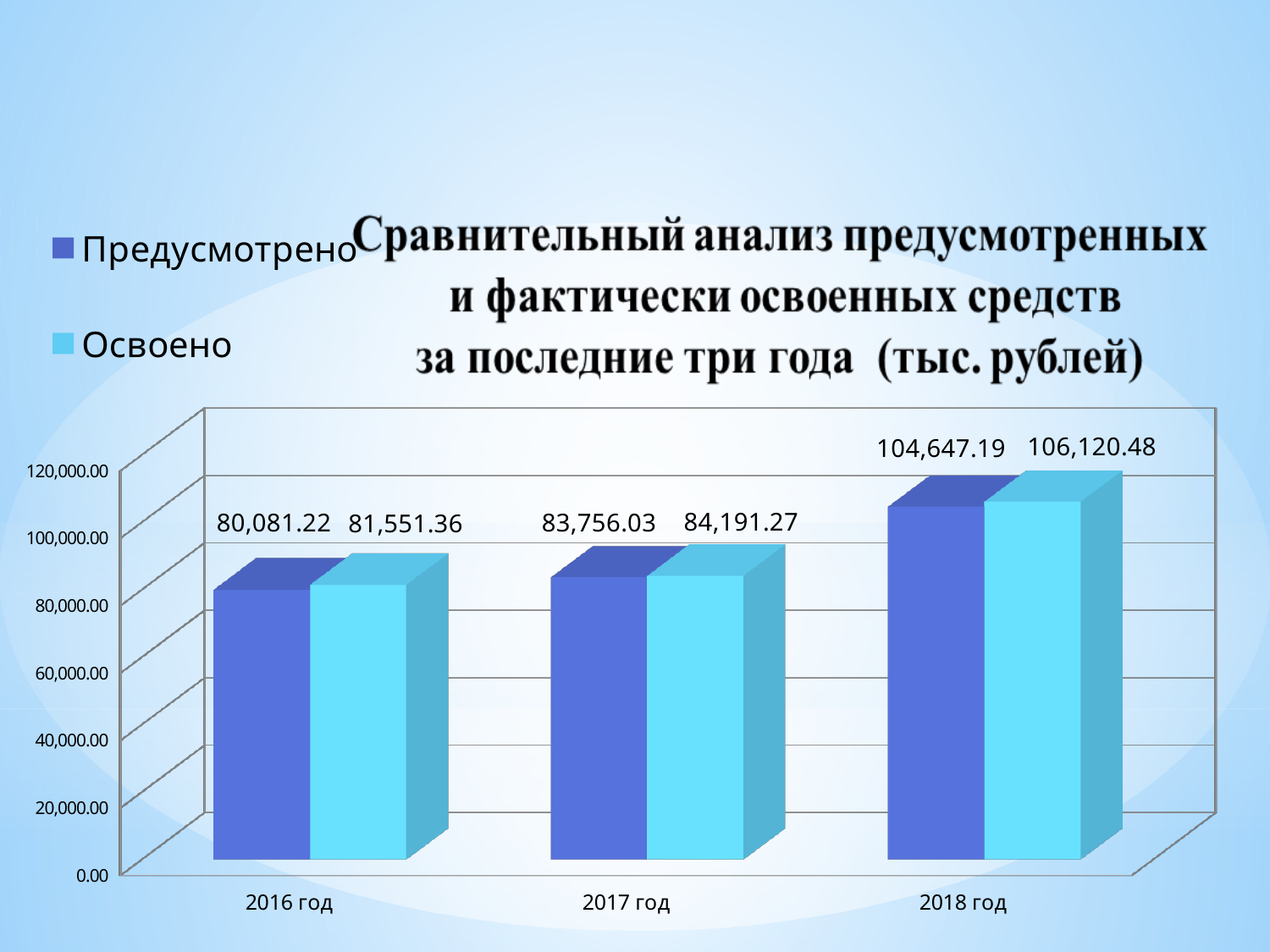
What is the difference between Освоено and Предусмотрено for 2018 год? 1,473.29 Which is larger for 2017 год: Предусмотрено or Освоено? Освоено What is the value of Освоено for 2017 год? 84,191.27 Is the value of Предусмотрено for 2018 год greater or less than 100,000.00? greater What kind of chart is shown on the slide? bar chart How many years are shown on the x axis? 3 What is the value of Освоено for 2018 год? 106,120.48 What is the difference between Предусмотрено for 2018 год and Предусмотрено for 2016 год? 24,565.97 What is the value of Предусмотрено for 2016 год? 80,081.22 How many series does the legend list? 2 Which year has the highest value for Освоено? 2018 год Which year has the lowest value for Предусмотрено? 2016 год